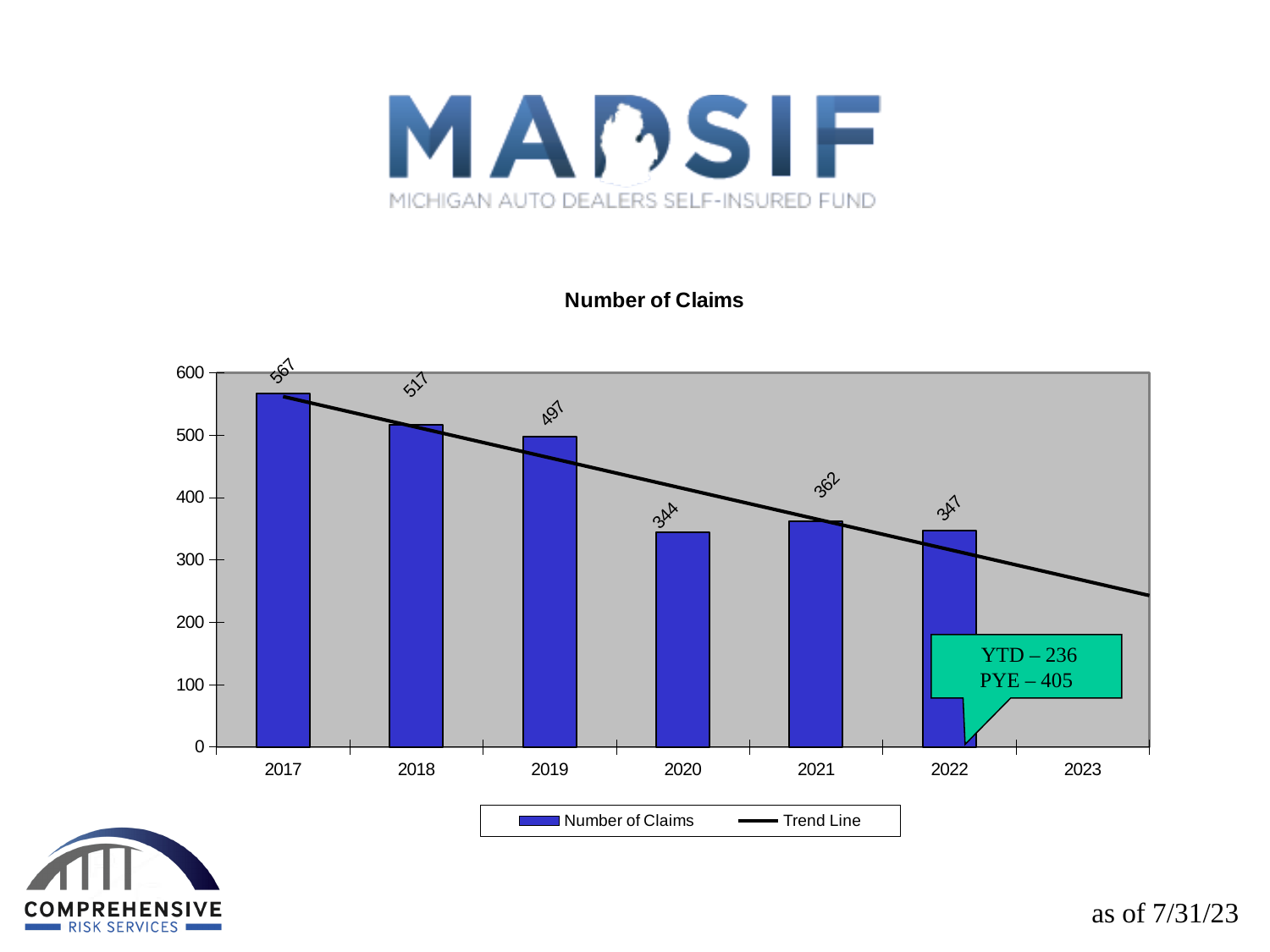
What is the number of claims for 2020? 344 What is the number of claims for 2017? 567 How many series does the legend list? 2 What is the difference in the number of claims between 2017 and 2018? 50 Which year has the lowest number of claims among the plotted bars? 2020 Which year has more claims, 2021 or 2022? 2021 What kind of chart is used to show the number of claims? Bar chart How many years have a bar plotted in the chart? 6 Which year has the highest number of claims? 2017 What is the title of the chart? Number of Claims What is the difference in the number of claims between 2019 and 2020? 153 What is the number of claims for 2022? 347